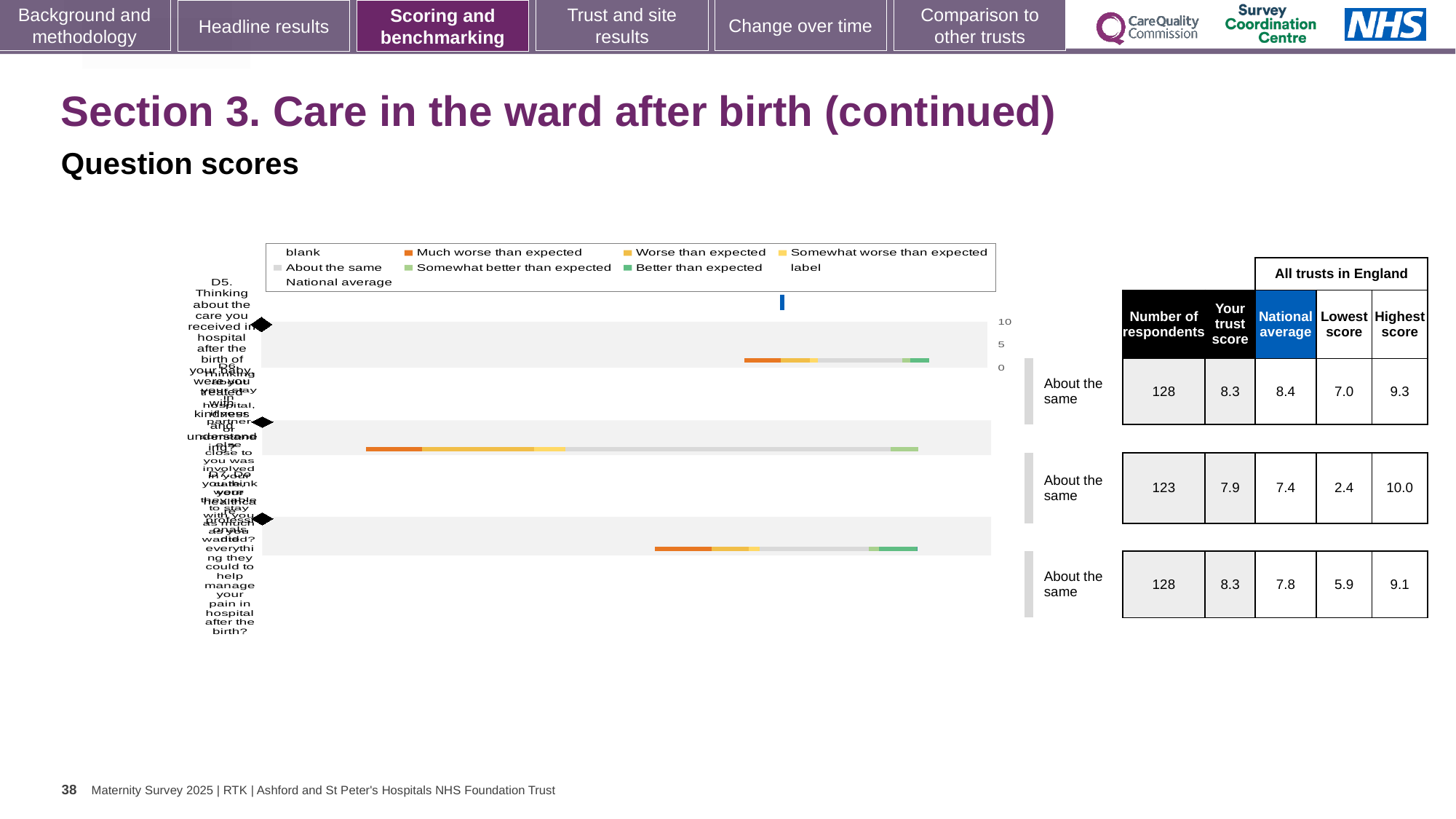
In the table next to the chart, what is the number of respondents in the second row? 123 What kind of chart is shown on the slide? bar chart In the table next to the chart, which row has the lowest 'Lowest score' value? the second row (2.4) In the table next to the chart, what is 'Your trust score' in the second row? 7.9 In the table next to the chart, which is larger in the second row: 'Your trust score' or the national average? Your trust score In the table next to the chart, what is the difference between 'Your trust score' and the national average in the third row? 0.5 How many stacked bars are plotted in the chart? 3 In the table next to the chart, which row has the highest 'Highest score' value? the second row (10.0) What colour in the chart legend represents 'Better than expected'? green What colour in the chart legend represents 'Much worse than expected'? orange In the table next to the chart, what is the lowest score in the second row? 2.4 In the table next to the chart, what is the national average in the first row? 8.4